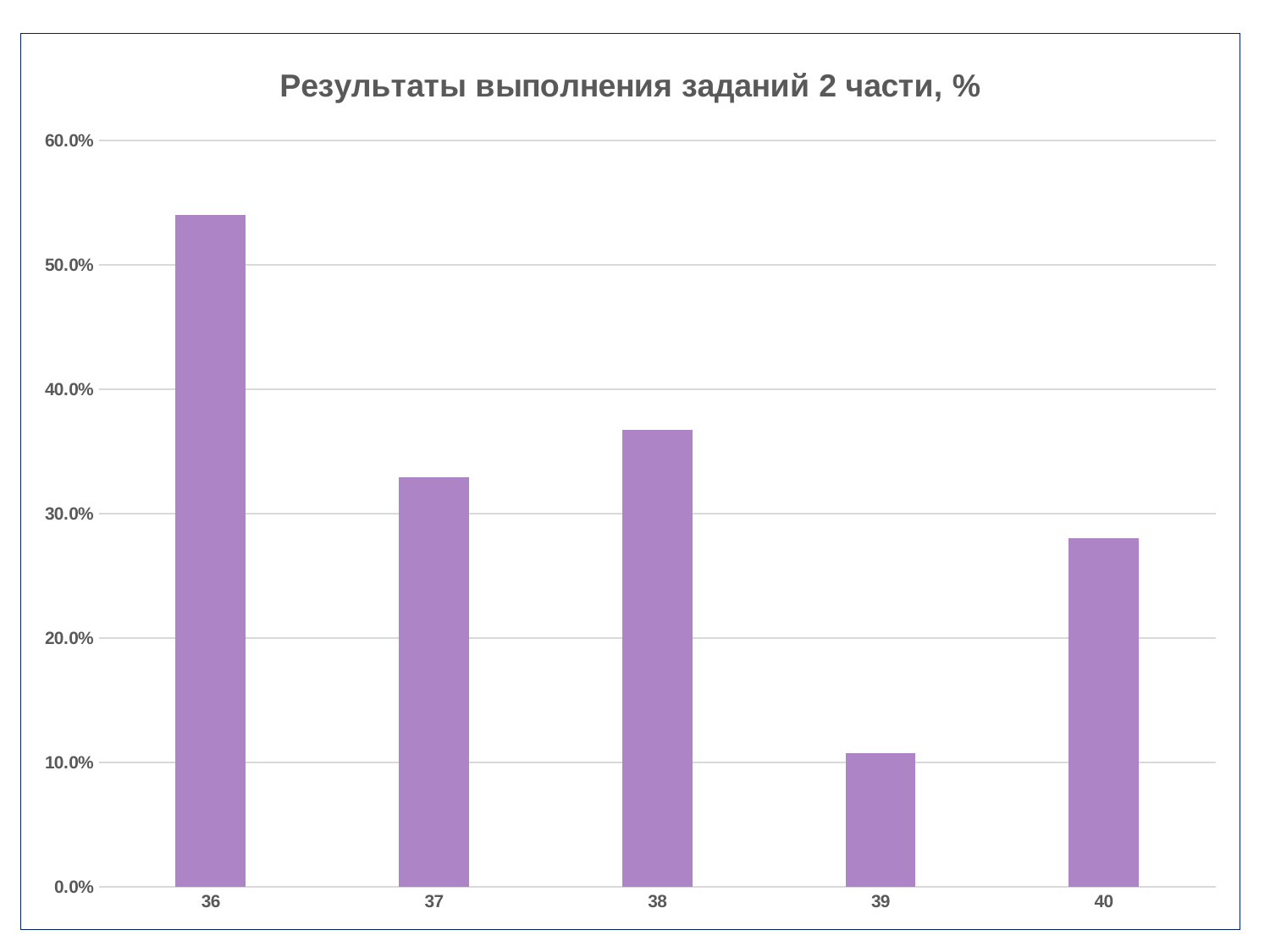
Is the value for task 36 greater or less than 50.0%? greater Is the value for task 37 greater or less than 30.0%? greater Which task number has the highest value? 36 How many categories (task numbers) are shown on the x axis? 5 Which has the larger value, task 37 or task 38? 38 Is the value for task 38 greater or less than 40.0%? less Does the value rise or fall from task 38 to task 39? fall Which task number has the lowest value? 39 What type of chart is shown on the slide? bar chart What is the title of the chart? Результаты выполнения заданий 2 части, %